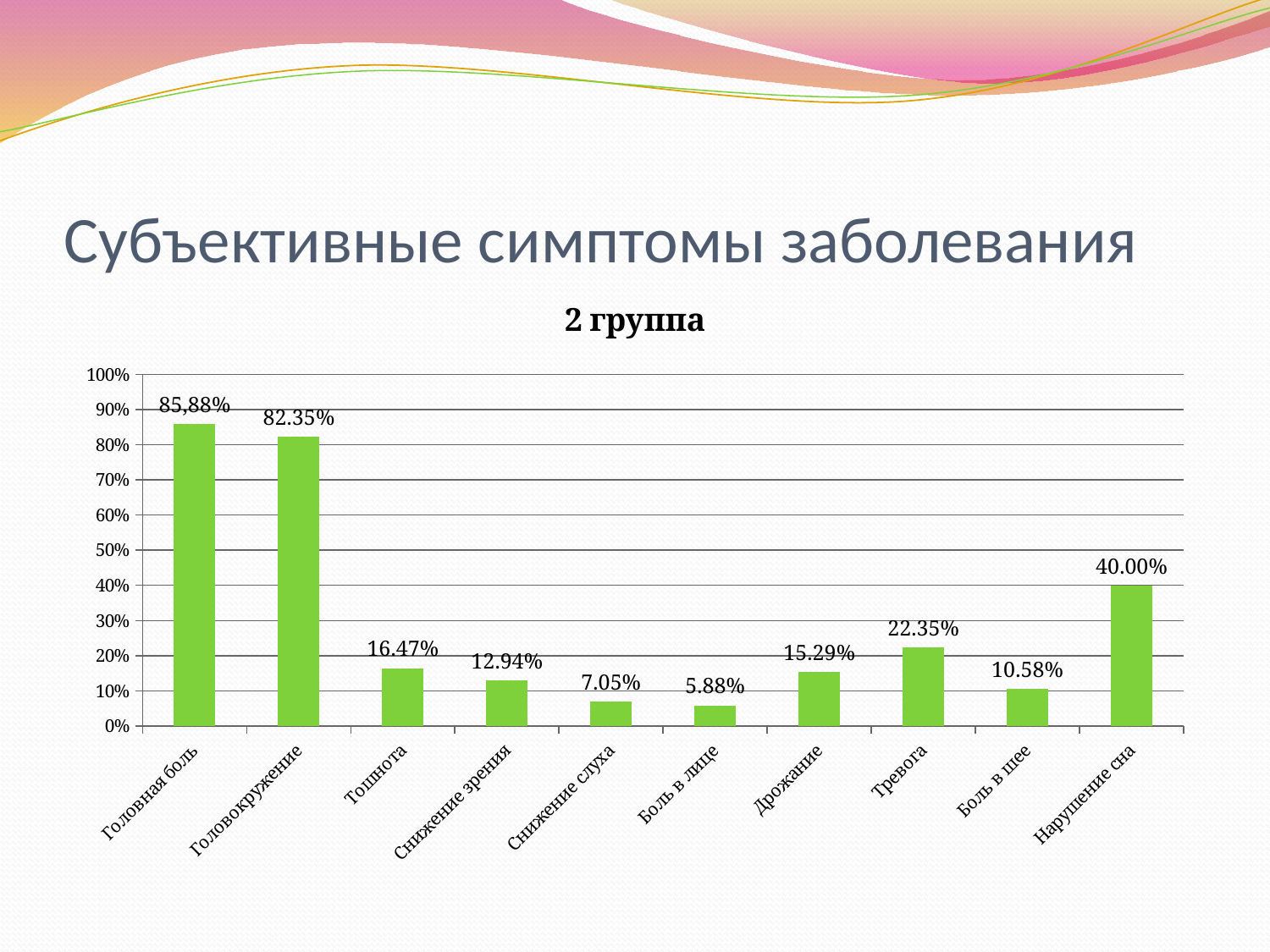
Is the value for Снижение слуха greater or less than 10%? less Which category has the lowest value? Боль в лице What is the value for Головокружение? 82.35% What is the difference between the values for Нарушение сна and Тревога? 17.65% What is the value for Тревога? 22.35% What is the title of the chart? 2 группа What is the value for Боль в шее? 10.58% Which is larger, the value for Тошнота or the value for Дрожание? Тошнота What type of chart is shown on the slide? bar chart What is the value for Нарушение сна? 40.00% How many categories are shown on the x axis of the chart? 10 Which category has the highest value? Головная боль